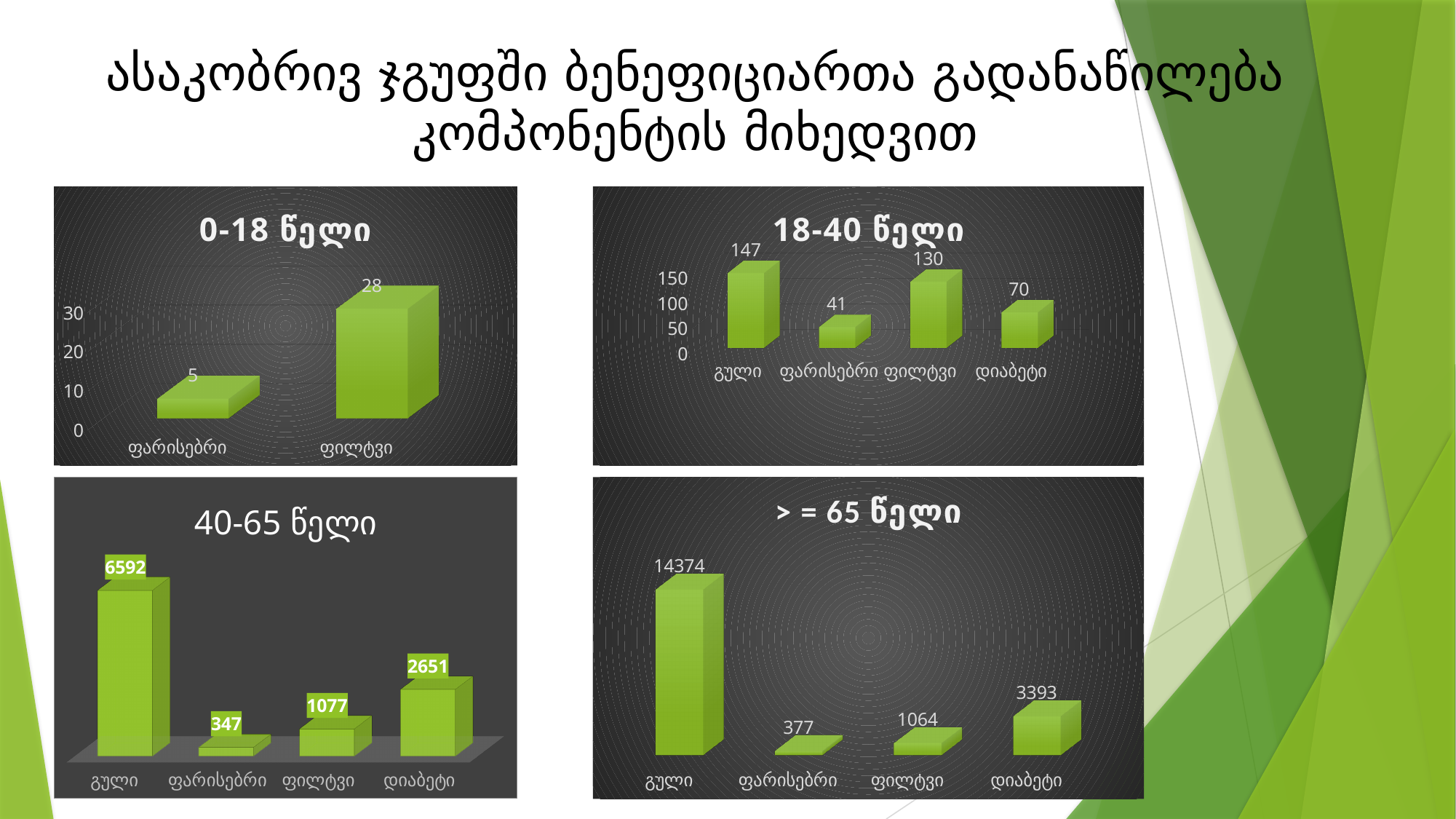
In the "40-65 წელი" chart, which is larger, ფილტვი or დიაბეტი? დიაბეტი In the "18-40 წელი" chart, what is the difference between გული and ფილტვი? 17 In the "> = 65 წელი" chart, what is the value for გული? 14374 In the "40-65 წელი" chart, which category has the lowest value? ფარისებრი In the "0-18 წელი" chart, what is the value for ფილტვი? 28 In the "> = 65 წელი" chart, what is the difference between დიაბეტი and ფილტვი? 2329 In the "18-40 წელი" chart, what is the value for ფარისებრი? 41 In the "0-18 წელი" chart, how many categories are shown? 2 In the "40-65 წელი" chart, what is the value for დიაბეტი? 2651 In the "0-18 წელი" chart, what is the difference between ფილტვი and ფარისებრი? 23 What type of chart is the "> = 65 წელი" chart? Bar chart In the "18-40 წელი" chart, which category has the highest value? გული